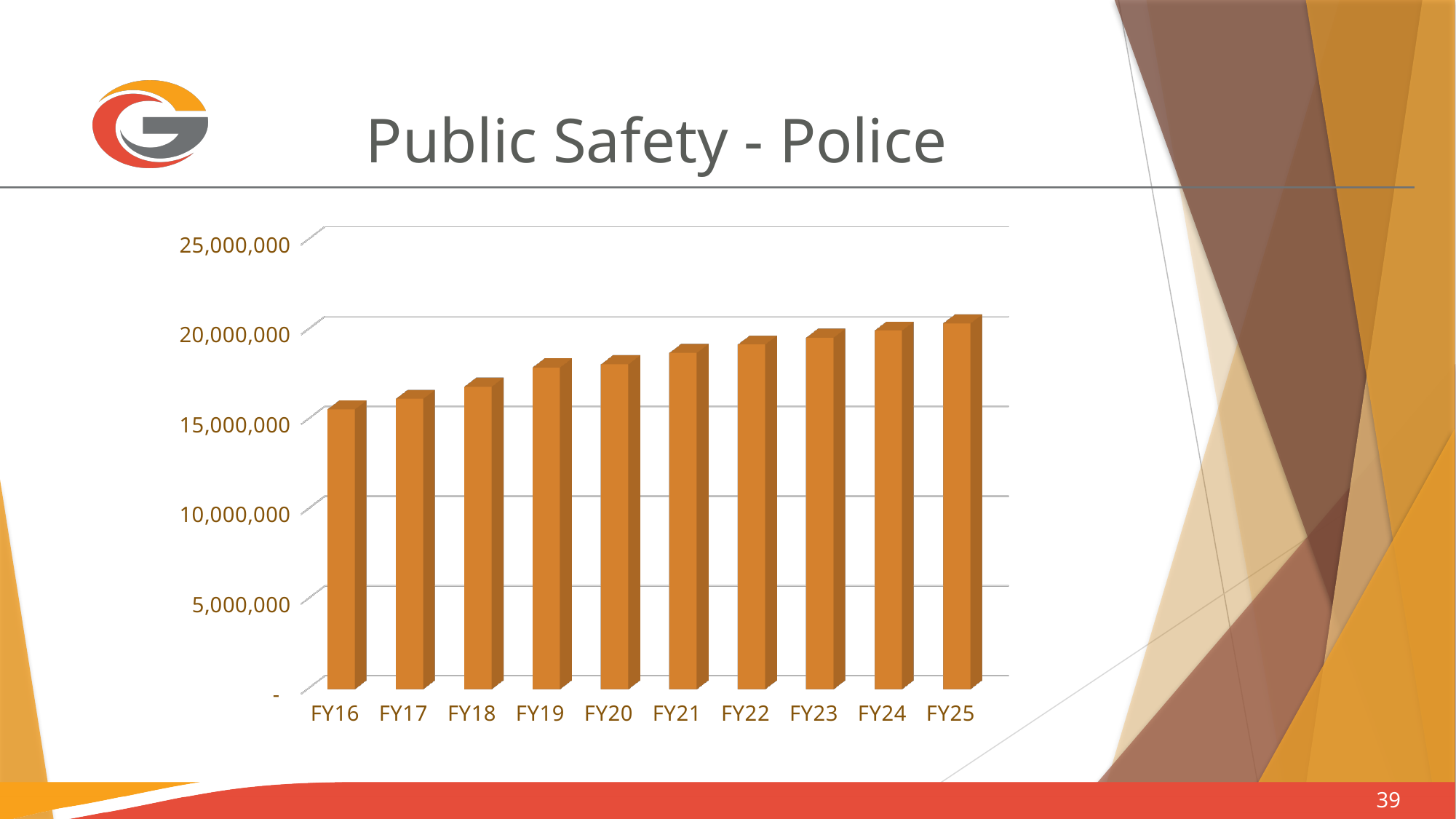
What is the title of the slide containing the chart? Public Safety - Police What kind of chart is shown on the slide? Bar chart Which fiscal year has the lowest bar? FY16 Do the values rise or fall from FY16 to FY25? Rise How many fiscal years are plotted on the x axis? 10 Is the value for FY20 greater or less than 15,000,000? greater Is the value for FY16 greater or less than 20,000,000? less Which is larger, the value for FY18 or the value for FY23? FY23 Which fiscal year has the highest bar? FY25 Is the value for FY20 greater or less than 20,000,000? less Which is larger, the value for FY16 or the value for FY25? FY25